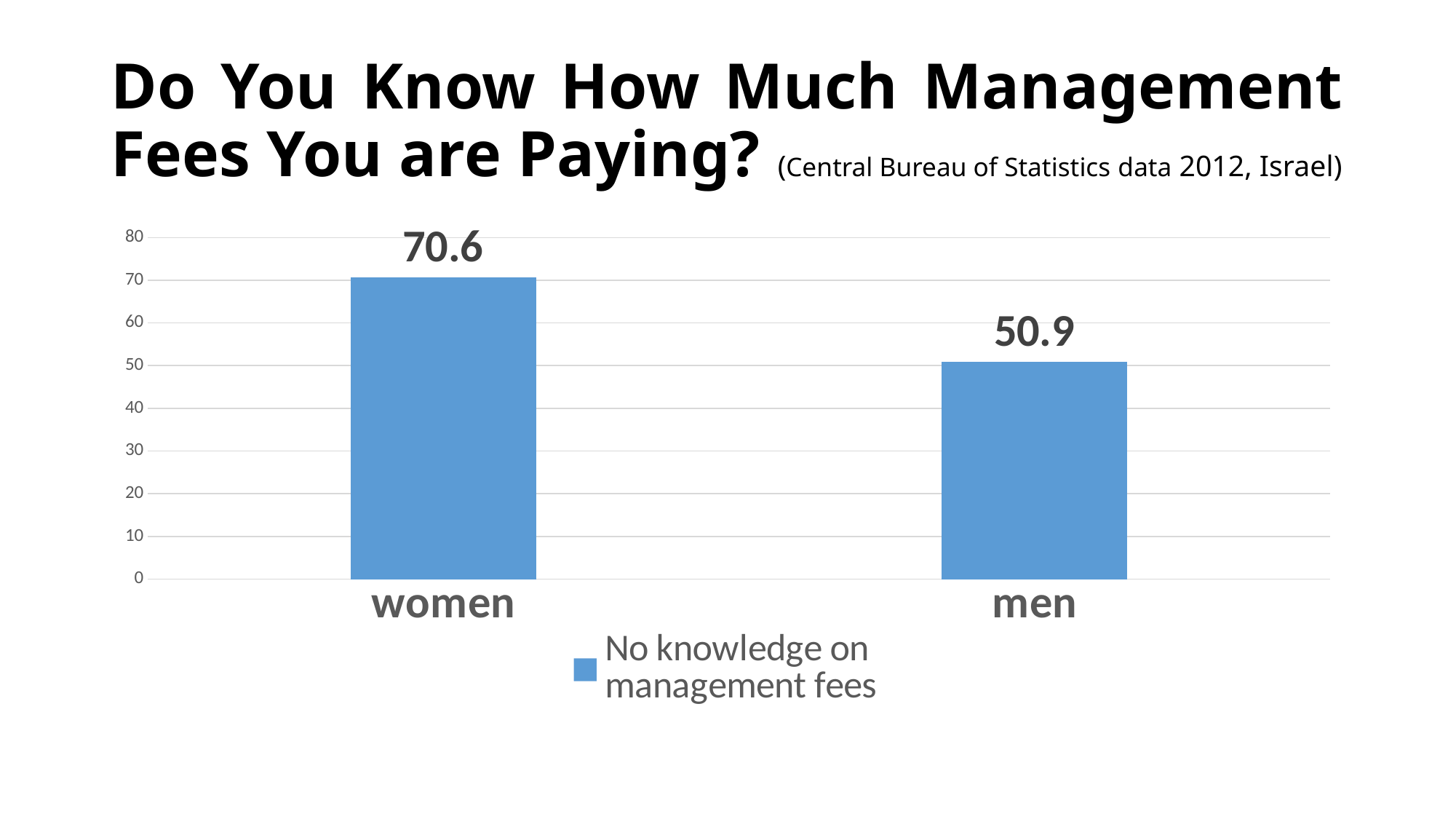
Which category has the lowest value? men Which category has the highest value? women What is the legend entry for the series? No knowledge on management fees What is the value for women? 70.6 Is the value for men greater or less than 60? less How many categories are shown on the x axis? 2 What kind of chart is shown on the slide? bar chart What is the difference between the values for women and men? 19.7 How many series does the legend list? 1 Is the value for women greater or less than 70? greater What is the value for men? 50.9 Which is larger, the value for women or the value for men? women